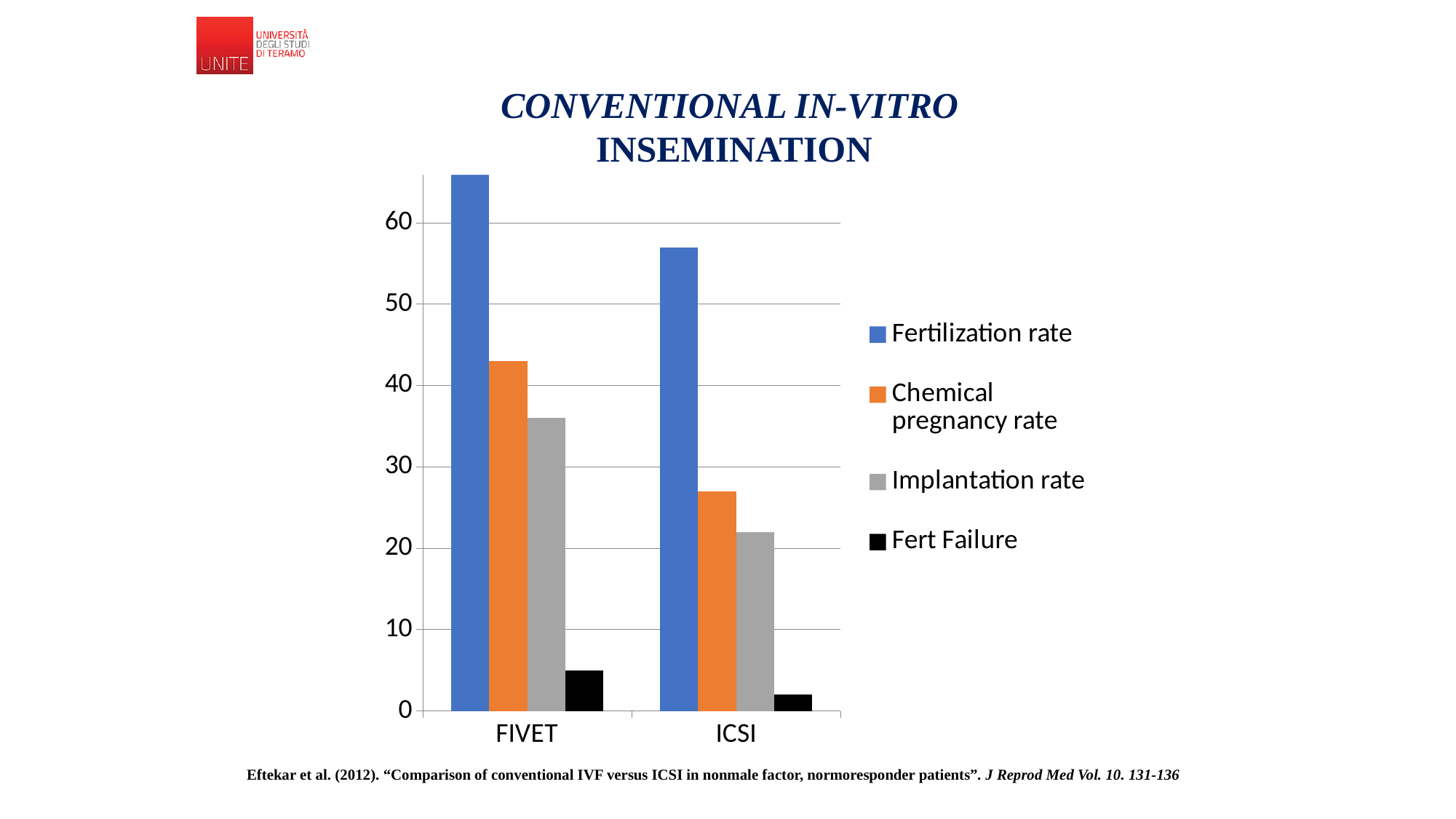
Is the Chemical pregnancy rate for FIVET greater or less than 40? greater Which series has the highest value for FIVET? Fertilization rate Which series has the lowest value for ICSI? Fert Failure Which is larger, the Chemical pregnancy rate for FIVET or for ICSI? FIVET Is the Fertilization rate for ICSI greater or less than 60? less Which is larger, the Fert Failure value for FIVET or for ICSI? FIVET How many series does the legend list? 4 What colour represents the Implantation rate series in the legend? grey How many categories are shown on the x axis? 2 What kind of chart is shown on the slide? bar chart Is the Implantation rate for ICSI greater or less than 30? less